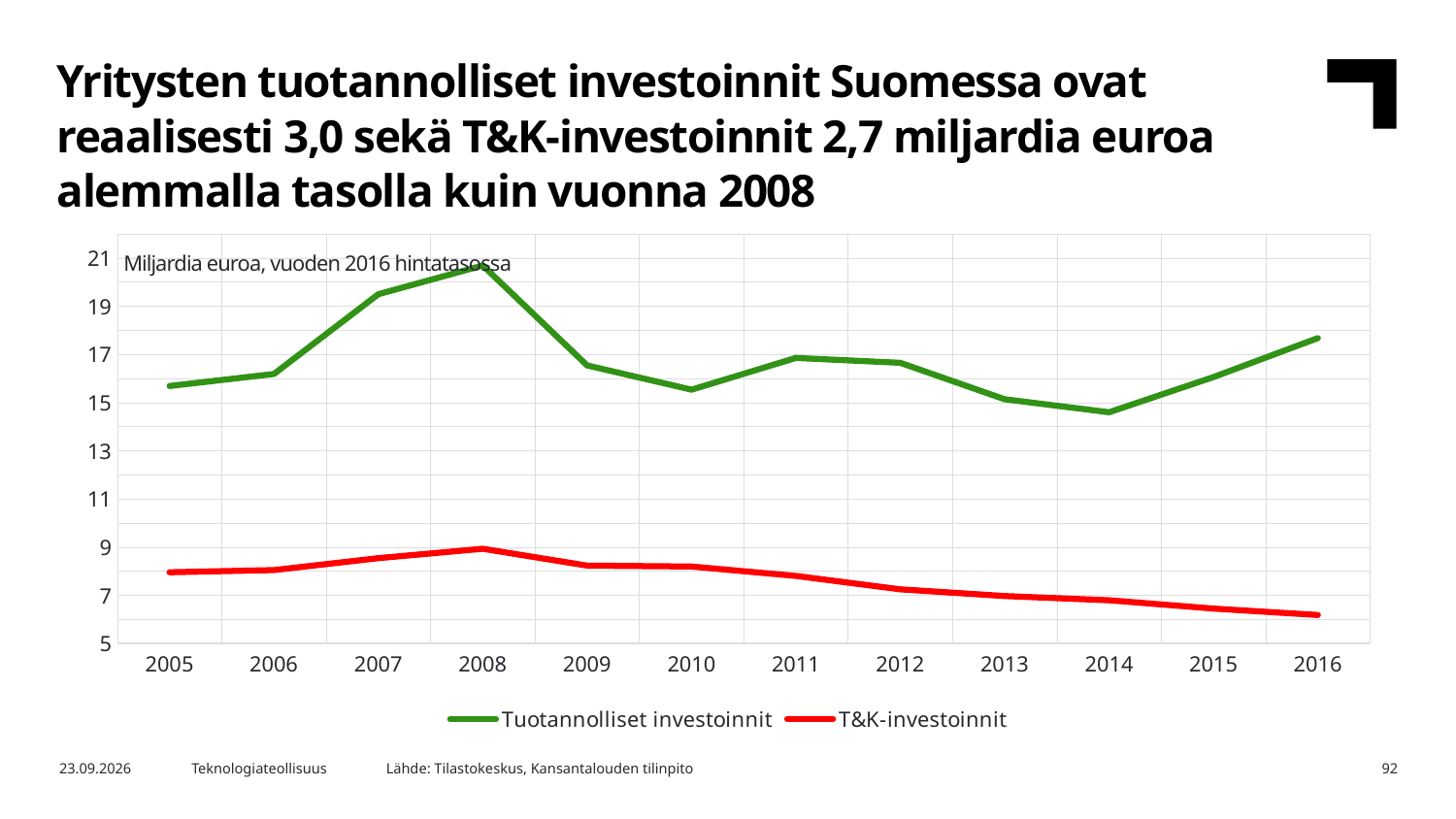
What kind of chart is shown on the slide? line chart In which year is the value for Tuotannolliset investoinnit highest? 2008 Does the T&K-investoinnit line generally rise or fall from 2008 to 2016? fall In which year is the value for T&K-investoinnit lowest? 2016 Is the value for T&K-investoinnit in 2016 greater or less than 7? less How many series does the legend list? 2 How many years are shown on the x axis of the chart? 12 In which year is the value for Tuotannolliset investoinnit lowest? 2014 Which is larger for Tuotannolliset investoinnit: the value in 2008 or the value in 2010? 2008 Is the value for Tuotannolliset investoinnit in 2014 greater or less than 15? less Is the value for Tuotannolliset investoinnit in 2008 greater or less than 19? greater What unit note is printed inside the chart area? Miljardia euroa, vuoden 2016 hintatasossa